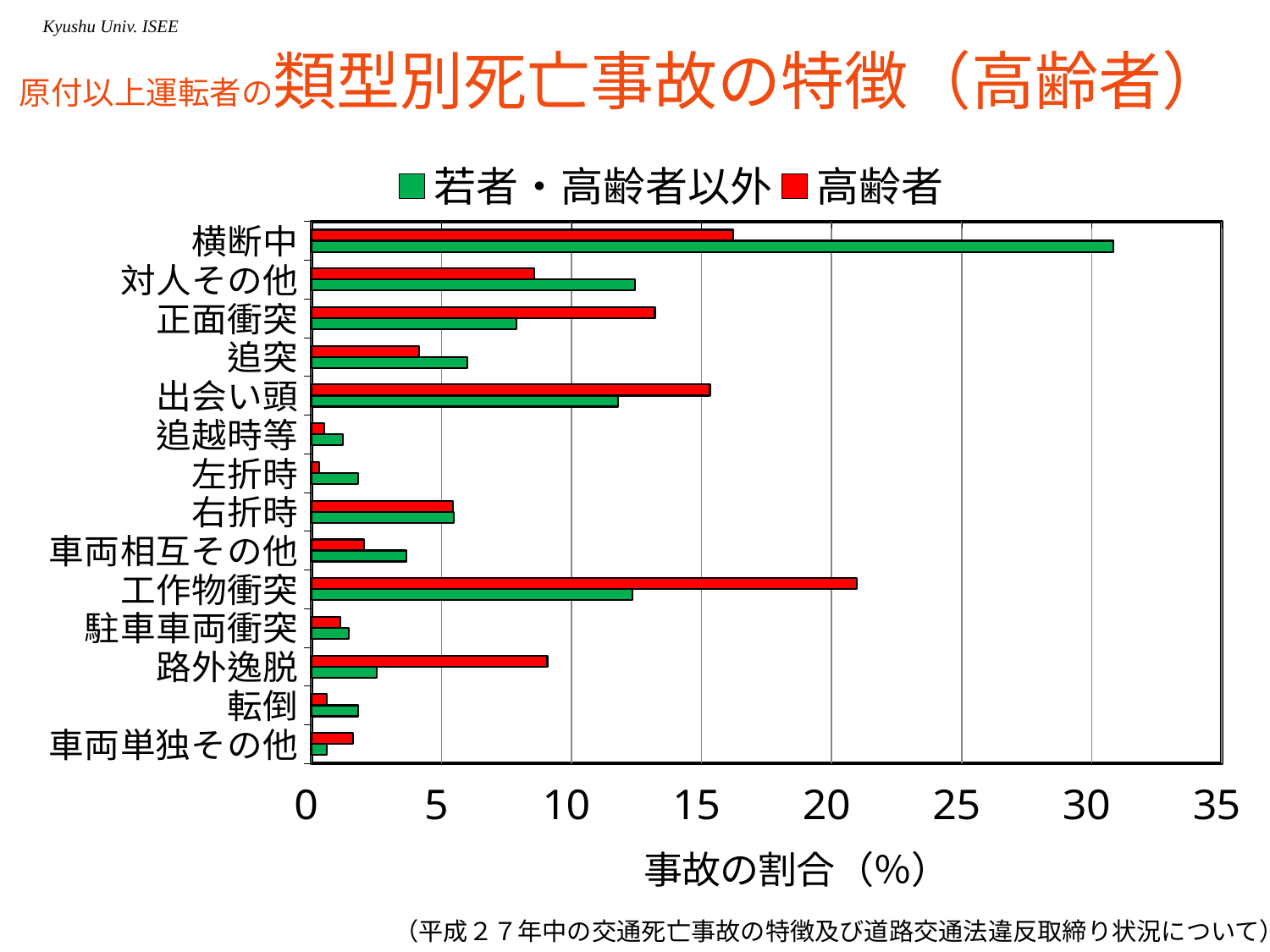
For 正面衝突, which series has the larger value, 若者・高齢者以外 or 高齢者? 高齢者 For 対人その他, which series has the larger value, 若者・高齢者以外 or 高齢者? 若者・高齢者以外 What kind of chart is shown on the slide? bar chart Which category has the highest value for 若者・高齢者以外? 横断中 How many series does the legend list? 2 Is the 高齢者 value for 工作物衝突 greater or less than 20? greater Is the 高齢者 value for 出会い頭 greater or less than 15? greater Is the 高齢者 value for 路外逸脱 greater or less than 10? less How many accident categories are shown on the vertical axis? 14 Which category has the highest value for 高齢者? 工作物衝突 What is the label of the horizontal axis? 事故の割合（%）